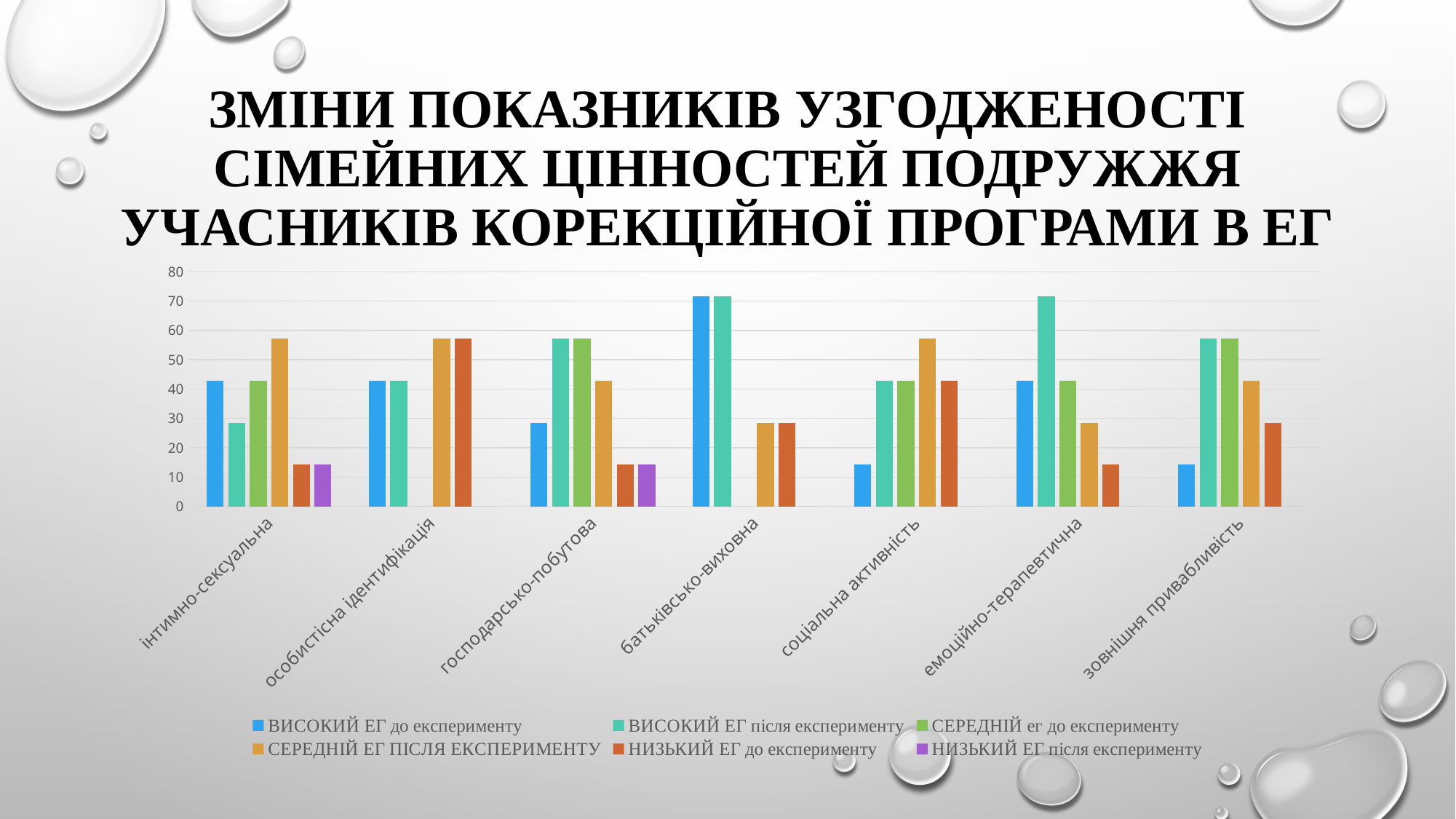
Which category has the highest value for "ВИСОКИЙ ЕГ до експерименту"? батьківсько-виховна For "господарсько-побутова", which is larger: "ВИСОКИЙ ЕГ до експерименту" or "ВИСОКИЙ ЕГ після експерименту"? ВИСОКИЙ ЕГ після експерименту What kind of chart is shown on the slide? bar chart Is the value of "НИЗЬКИЙ ЕГ після експерименту" for "інтимно-сексуальна" greater or less than 20? less Is the value of "ВИСОКИЙ ЕГ до експерименту" for "батьківсько-виховна" greater or less than 60? greater How many categories are shown along the x axis of the chart? 7 How many series does the chart's legend list? 6 For "соціальна активність", which is larger: "ВИСОКИЙ ЕГ до експерименту" or "ВИСОКИЙ ЕГ після експерименту"? ВИСОКИЙ ЕГ після експерименту Is the value of "ВИСОКИЙ ЕГ після експерименту" for "інтимно-сексуальна" greater or less than 40? less For "емоційно-терапевтична", which is larger: "ВИСОКИЙ ЕГ після експерименту" or "СЕРЕДНІЙ ег до експерименту"? ВИСОКИЙ ЕГ після експерименту What colour represents the series "ВИСОКИЙ ЕГ до експерименту" in the chart? blue